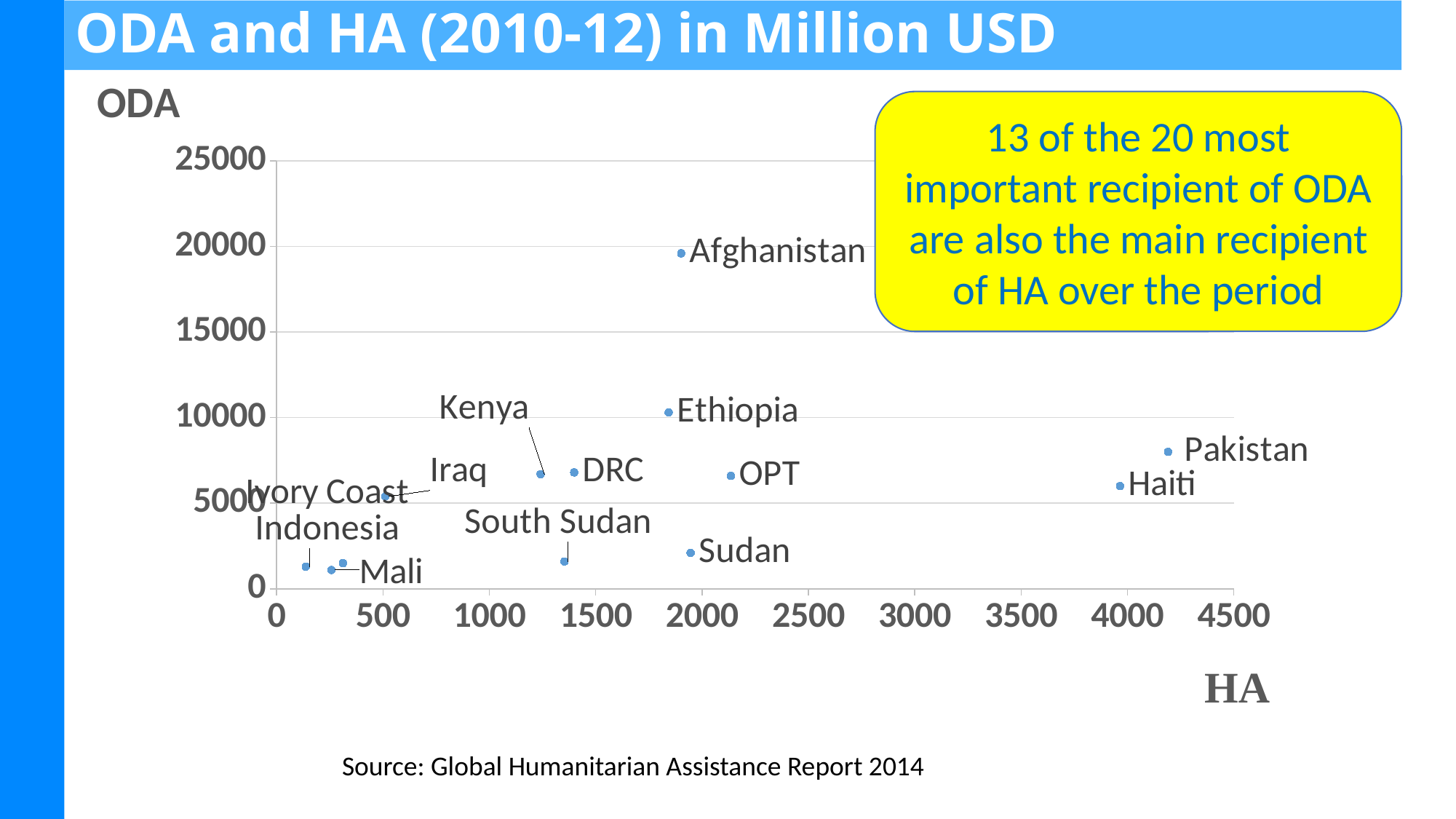
Which country has the highest ODA value on the chart? Afghanistan How many countries are plotted as points on the chart? 13 Which has the larger ODA value, Afghanistan or Ethiopia? Afghanistan Is the HA value for Pakistan greater or less than 4000? greater Which country has the highest HA value on the chart? Pakistan Is the ODA value for Afghanistan greater or less than 15000? greater What is the title of the chart? ODA and HA (2010-12) in Million USD Which country has the lowest HA value on the chart? Indonesia What kind of chart is shown on the slide? scatter chart Is the HA value for Afghanistan greater or less than 2000? less Which has the larger ODA value, Pakistan or Haiti? Pakistan